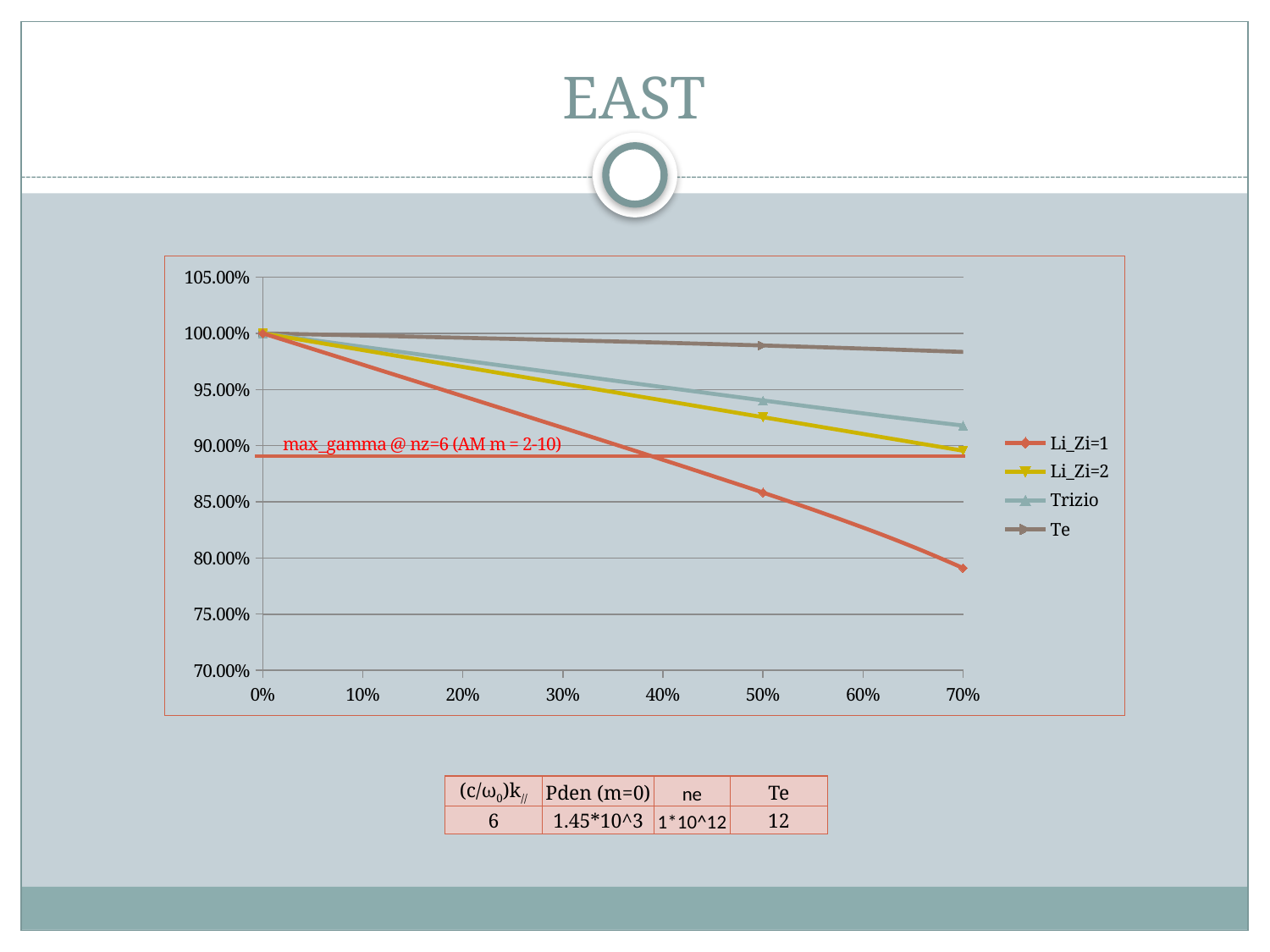
What is the label written on the horizontal red line in the chart? max_gamma @ nz=6 (AM m = 2-10) What kind of chart is shown on the slide? line chart What are the series names listed in the legend? Li_Zi=1, Li_Zi=2, Trizio, Te How many series does the legend list? 4 Which series has the highest value at 70%? Te What is the value of the Te series at 0%? 100.00% Is the value for Te at 70% greater or less than 95.00%? greater Is the value for Li_Zi=2 at 50% greater or less than 90.00%? greater Is the value for Li_Zi=1 at 70% greater or less than 85.00%? less Which series has the lowest value at 70%? Li_Zi=1 Do the values of the Li_Zi=1 series rise or fall as the x axis increases? fall At 70%, which series has the larger value, Trizio or Li_Zi=2? Trizio